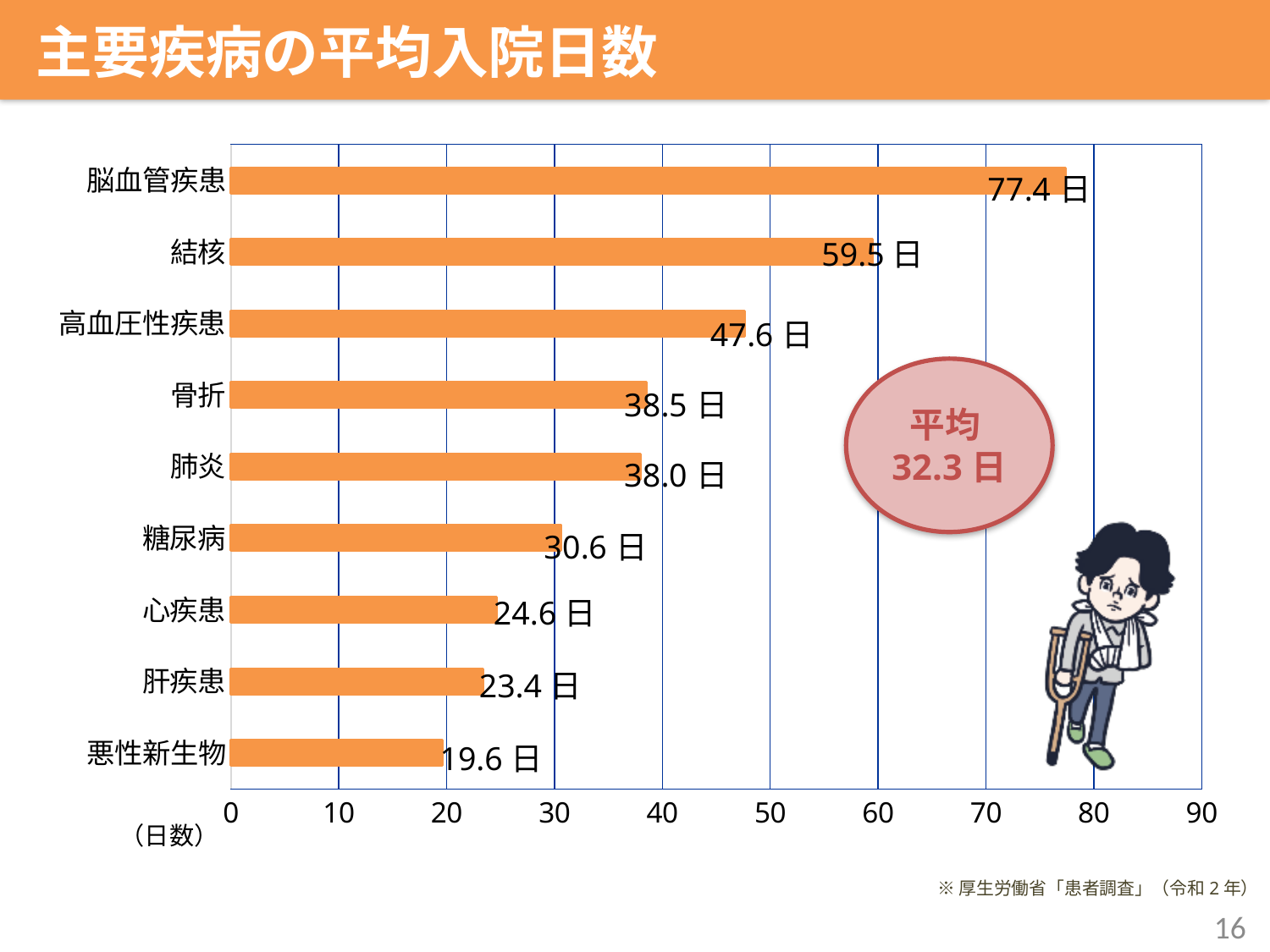
Which disease has the longest average hospital stay? 脳血管疾患 What is the average hospital stay for 糖尿病? 30.6 日 How many diseases are shown in the chart? 9 What is the average hospital stay for 脳血管疾患? 77.4 日 Is the value for 骨折 greater or less than 40? less Which has a longer average hospital stay, 心疾患 or 肺炎? 肺炎 What is the average hospital stay for 肝疾患? 23.4 日 What is the title of the slide? 主要疾病の平均入院日数 What kind of chart is shown on the slide? bar chart Which disease has the shortest average hospital stay? 悪性新生物 What is the difference in average hospital stay between 結核 and 高血圧性疾患? 11.9 日 What is the overall average hospital stay shown in the circle on the chart? 32.3 日